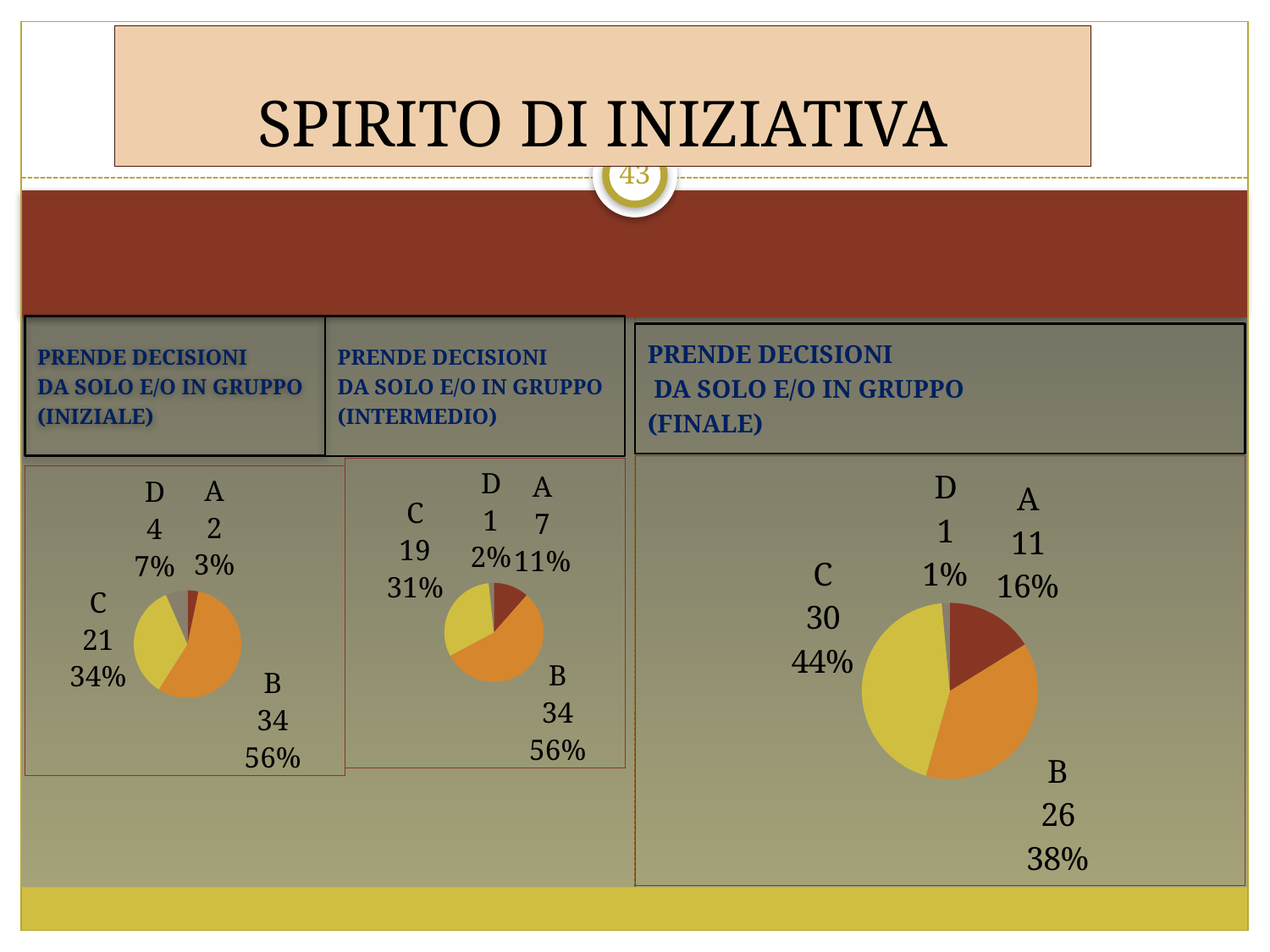
In the FINALE pie chart, what is the difference between the counts for C and B? 4 In the INTERMEDIO pie chart, which category has the largest share? B What type of chart is used in the FINALE panel? Pie chart In the INIZIALE pie chart, which category has the smallest share? A In the INIZIALE pie chart, what percentage share does category B have? 56% In the INTERMEDIO pie chart, what percentage share does category C have? 31% In the FINALE pie chart, what is the count for category B? 26 How many categories are shown in the INIZIALE pie chart? 4 In the INIZIALE pie chart, what is the count for category C? 21 In the INTERMEDIO pie chart, what is the count for category A? 7 In the FINALE pie chart, what percentage share does category A have? 16% In the FINALE pie chart, which category has the largest share? C